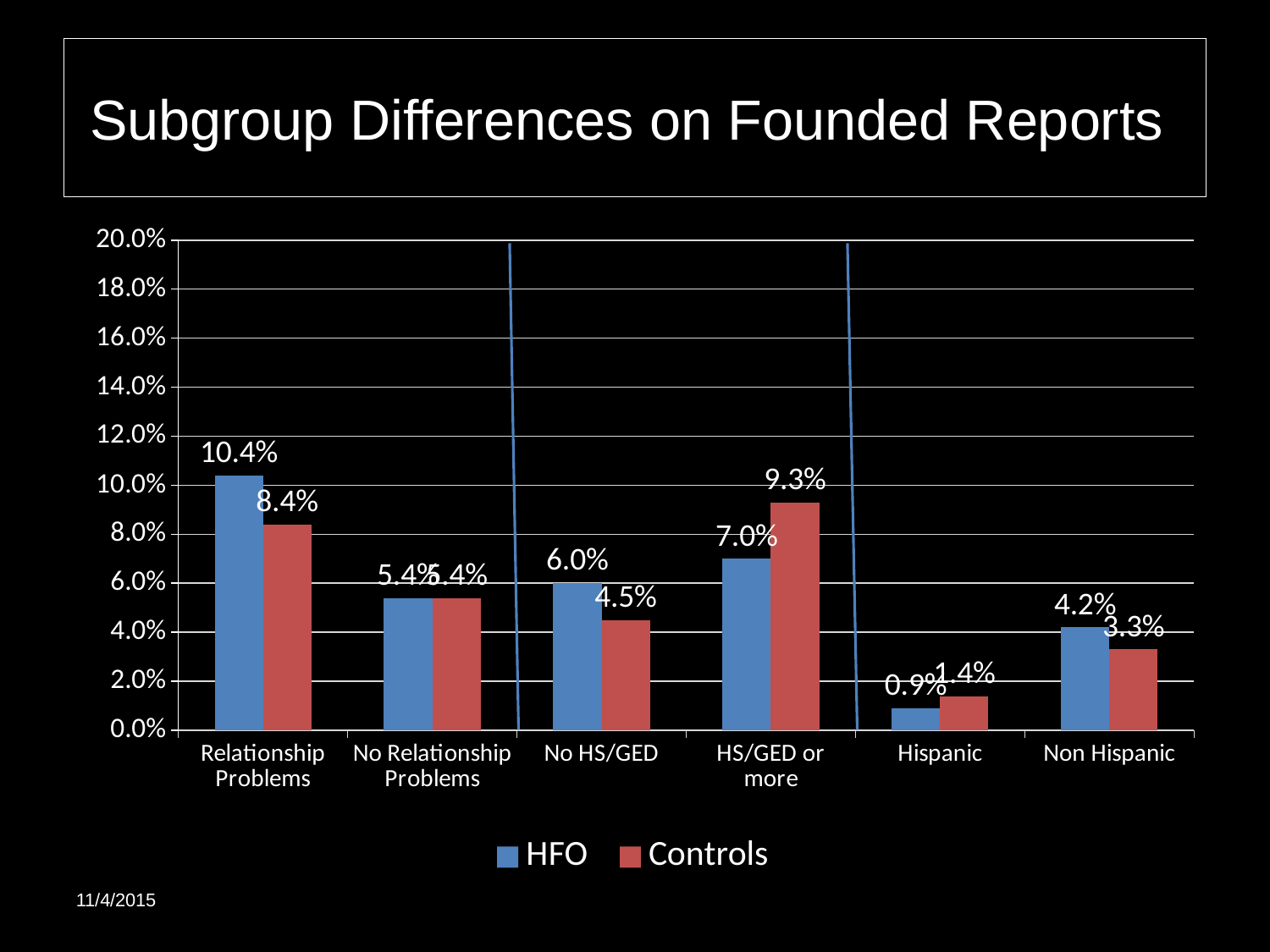
What is the Controls value for HS/GED or more? 9.3% What is the difference between the Controls and HFO values for HS/GED or more? 2.3% Which category has the highest HFO value? Relationship Problems Which is larger for No HS/GED, the HFO value or the Controls value? HFO What is the Controls value for Hispanic? 1.4% What is the difference between the HFO and Controls values for Relationship Problems? 2.0% What is the title of the slide? Subgroup Differences on Founded Reports How many series does the legend list? 2 How many categories are shown on the x axis? 6 What is the HFO value for Relationship Problems? 10.4% What kind of chart is shown on the slide? Bar chart Which category has the lowest Controls value? Hispanic